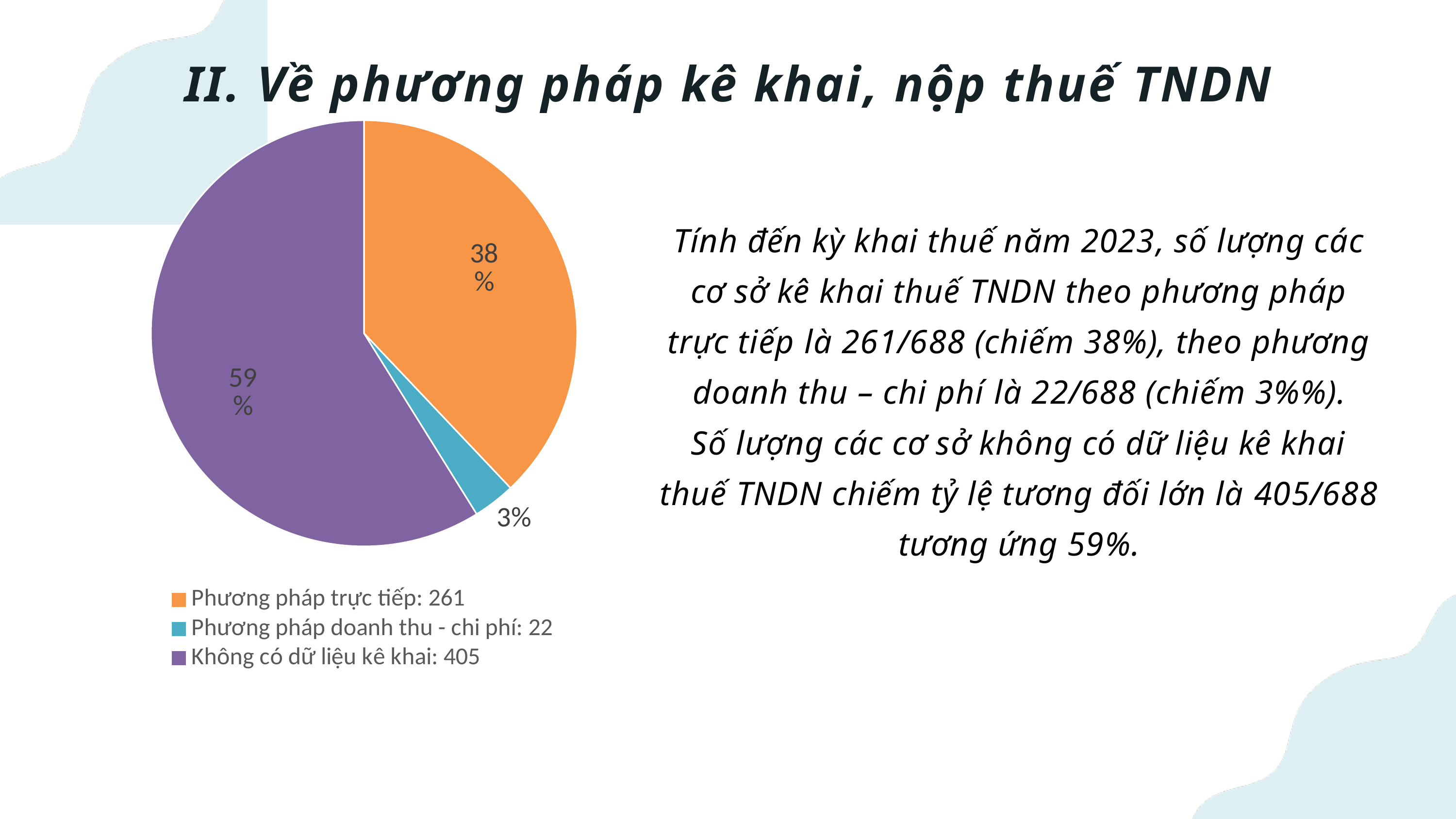
How many slices does the pie chart have? 3 Which slice of the pie chart is the smallest? Phương pháp doanh thu - chi phí What value is shown in the legend for 'Phương pháp doanh thu - chi phí'? 22 How many entries does the legend of the pie chart list? 3 What percentage share does the slice 'Phương pháp trực tiếp' have in the pie chart? 38% What value is shown in the legend for 'Không có dữ liệu kê khai'? 405 What percentage share does the slice 'Không có dữ liệu kê khai' have in the pie chart? 59% What kind of chart is shown on the slide? Pie chart What value is shown in the legend for 'Phương pháp trực tiếp'? 261 What percentage share does the slice 'Phương pháp doanh thu - chi phí' have in the pie chart? 3% What is the difference between the legend values for 'Không có dữ liệu kê khai' and 'Phương pháp trực tiếp'? 144 Which slice of the pie chart is the largest? Không có dữ liệu kê khai